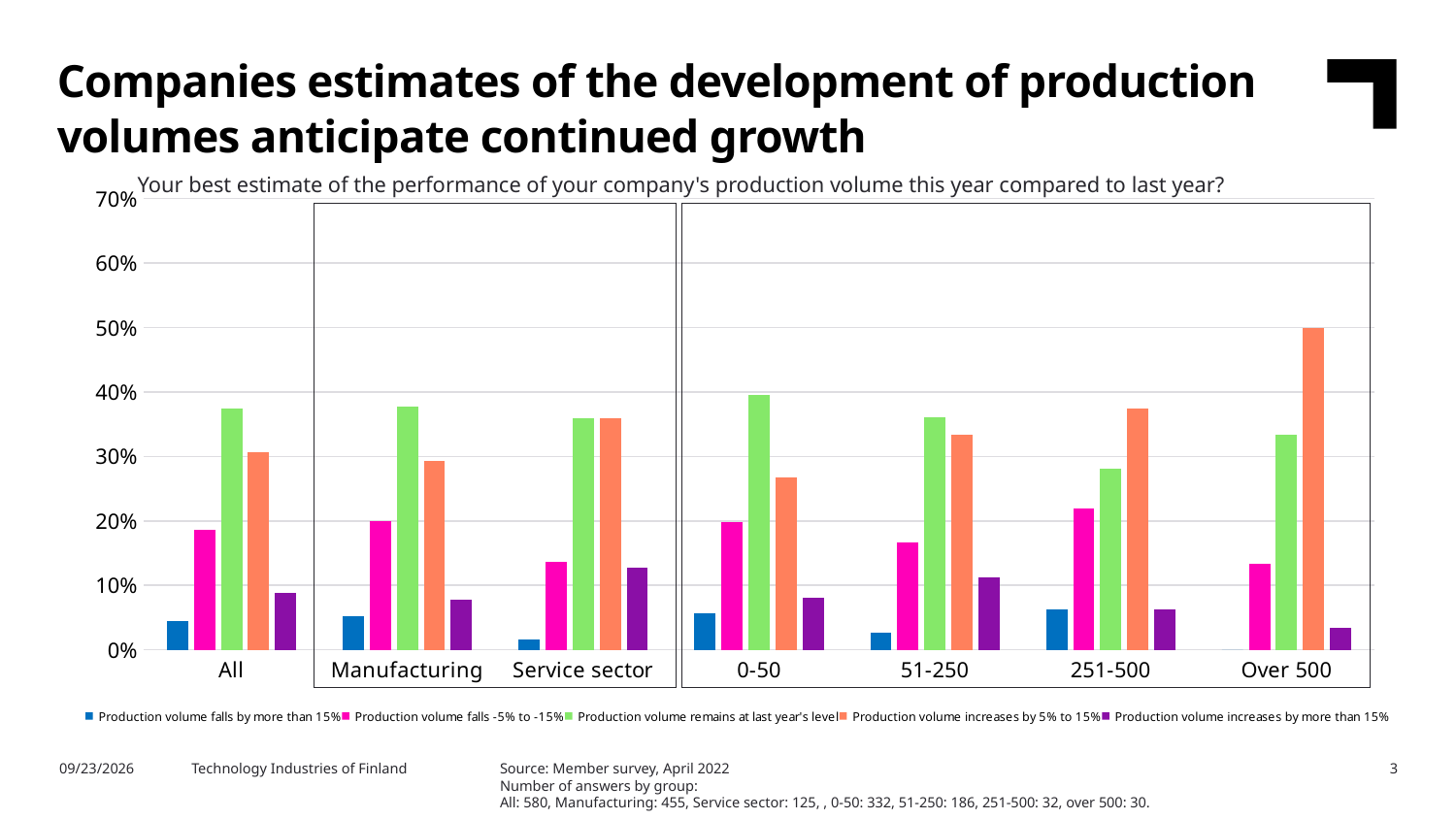
Is the value for 'Production volume falls -5% to -15%' in the Manufacturing category greater or less than 30%? less How many categories are shown along the x axis of the chart? 7 Which category has the highest value for 'Production volume increases by 5% to 15%'? Over 500 In the All category, which is larger: 'Production volume falls -5% to -15%' or 'Production volume increases by more than 15%'? Production volume falls -5% to -15% Is the value for 'Production volume increases by 5% to 15%' in the Over 500 category greater or less than 40%? greater In the 251-500 category, which is larger: 'Production volume remains at last year's level' or 'Production volume increases by 5% to 15%'? Production volume increases by 5% to 15% What kind of chart is shown on the slide? bar chart Is the value for 'Production volume falls by more than 15%' in the All category greater or less than 10%? less What is the title of the chart? Your best estimate of the performance of your company's production volume this year compared to last year? Which category has the lowest value for 'Production volume increases by more than 15%'? Over 500 How many series does the legend list? 5